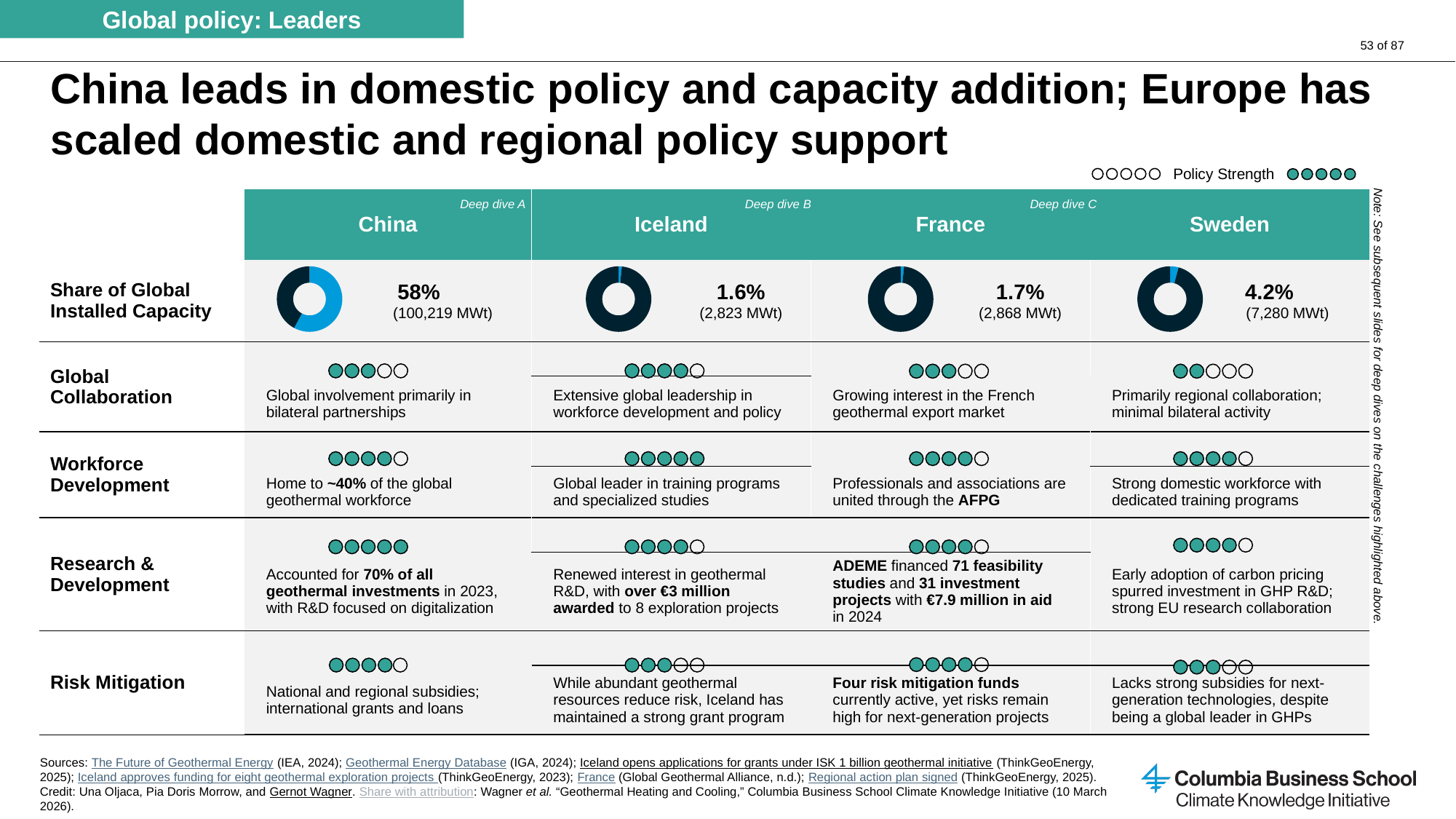
Among the four Share of Global Installed Capacity donut charts, which country has the lowest share? Iceland In the Share of Global Installed Capacity donut charts, what colour is the segment representing each country's share? Blue How many Share of Global Installed Capacity donut charts are shown on the slide? 4 In the Share of Global Installed Capacity donut charts, what share is shown for China? 58% In the Share of Global Installed Capacity donut charts, how much larger is China's installed capacity than Sweden's, in MWt? 92,939 MWt In the Share of Global Installed Capacity donut charts, how many percentage points higher is Sweden's share than France's? 2.5 percentage points In the Share of Global Installed Capacity donut charts, what share is shown for France? 1.7% In the Share of Global Installed Capacity donut charts, what installed capacity in MWt is shown for Sweden? 7,280 MWt In the Share of Global Installed Capacity donut charts, what installed capacity in MWt is shown for Iceland? 2,823 MWt Among the four Share of Global Installed Capacity donut charts, which country has the highest share? China In the Share of Global Installed Capacity donut charts, which has the larger share, France or Iceland? France What type of chart is used to show each country's Share of Global Installed Capacity? Donut (pie) chart